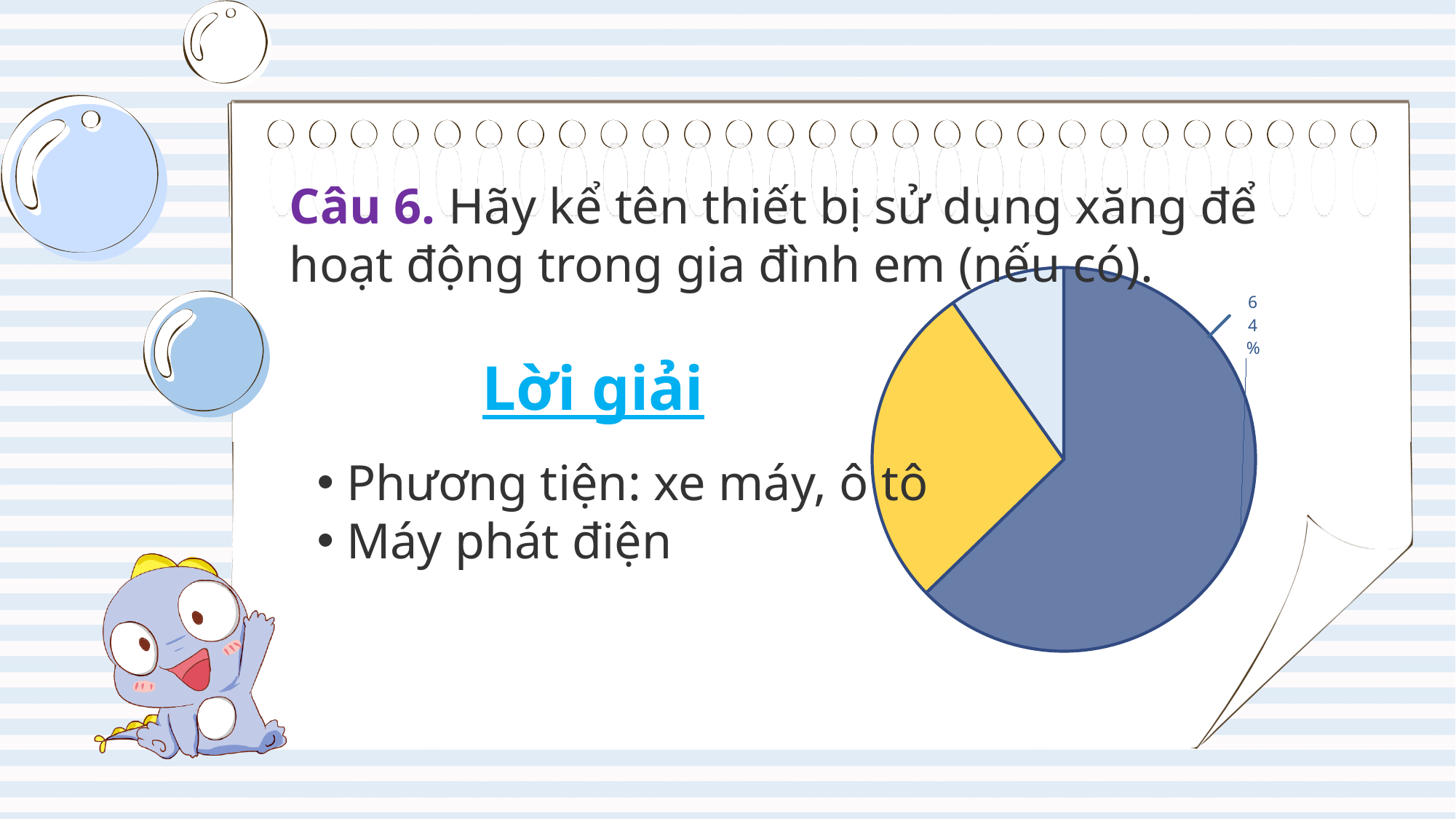
Does the largest slice of the pie chart account for more or less than half of the pie? more Which is larger in the pie chart, the dark blue slice or the yellow slice? the dark blue slice How many slices does the pie chart have? 3 What colour is the slice labelled 64% in the pie chart? dark blue What kind of chart is shown on the slide? pie chart Which is larger in the pie chart, the yellow slice or the light blue slice? the yellow slice Does the pie chart display a legend? No Which slice of the pie chart is the smallest? the light blue slice What share of the pie does the dark blue slice represent? 64% Which slice of the pie chart is the largest? the dark blue slice What percentage is printed as the data label on the pie chart? 64%